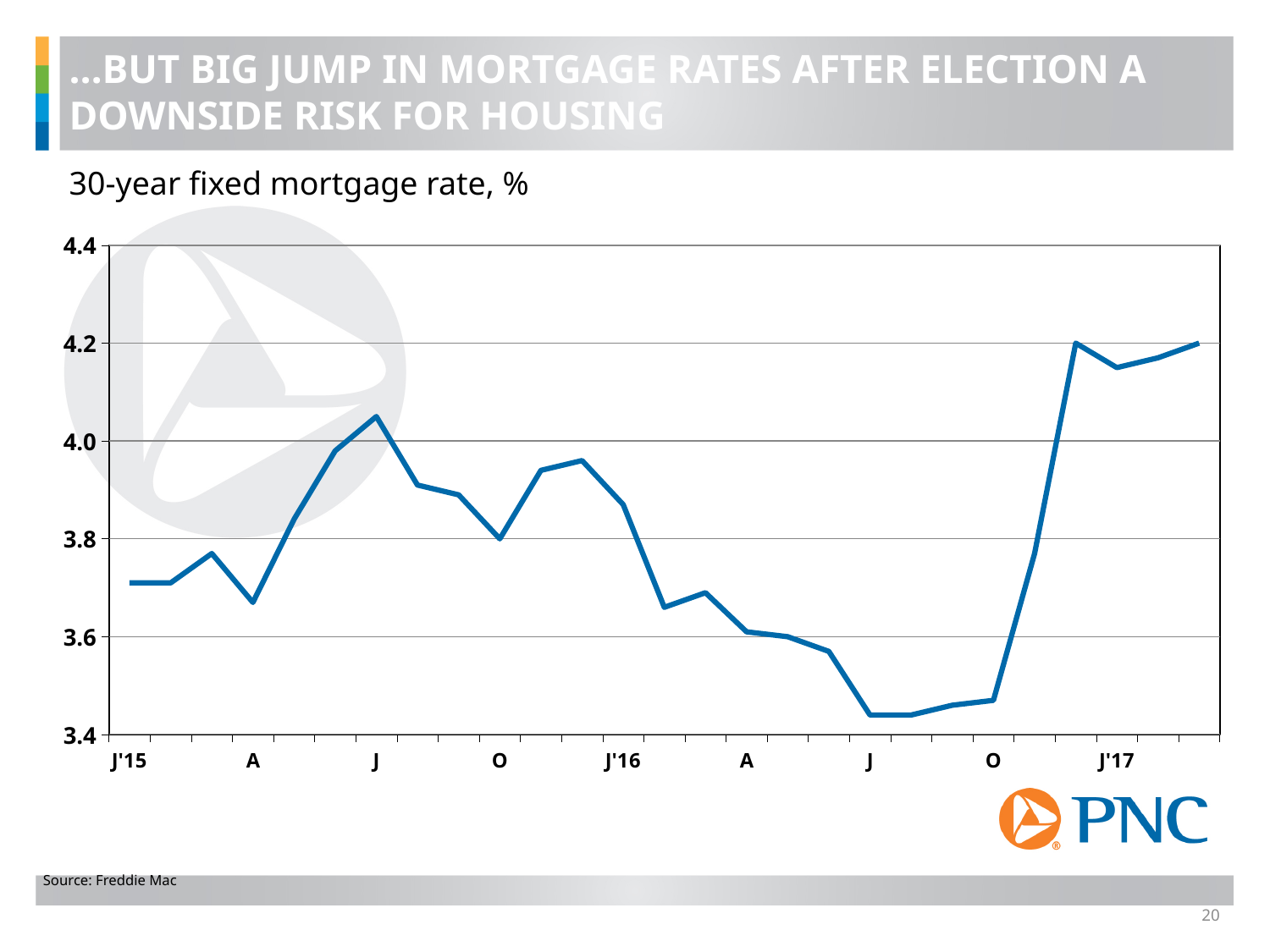
Does the mortgage rate rise or fall between J'16 and J (July 2016)? fall Is the value for J (July 2015) greater or less than 4.0? greater What is the title of the chart? 30-year fixed mortgage rate, % Is the value for J'15 greater or less than 3.8? less Is the value for J'15 greater or less than 3.6? greater What kind of chart is shown on the slide? line chart Which is larger, the value for J (July 2015) or the value for J (July 2016)? J (July 2015) Does the mortgage rate rise or fall between O (October 2016) and J'17? rise What is the source cited for the chart data? Freddie Mac